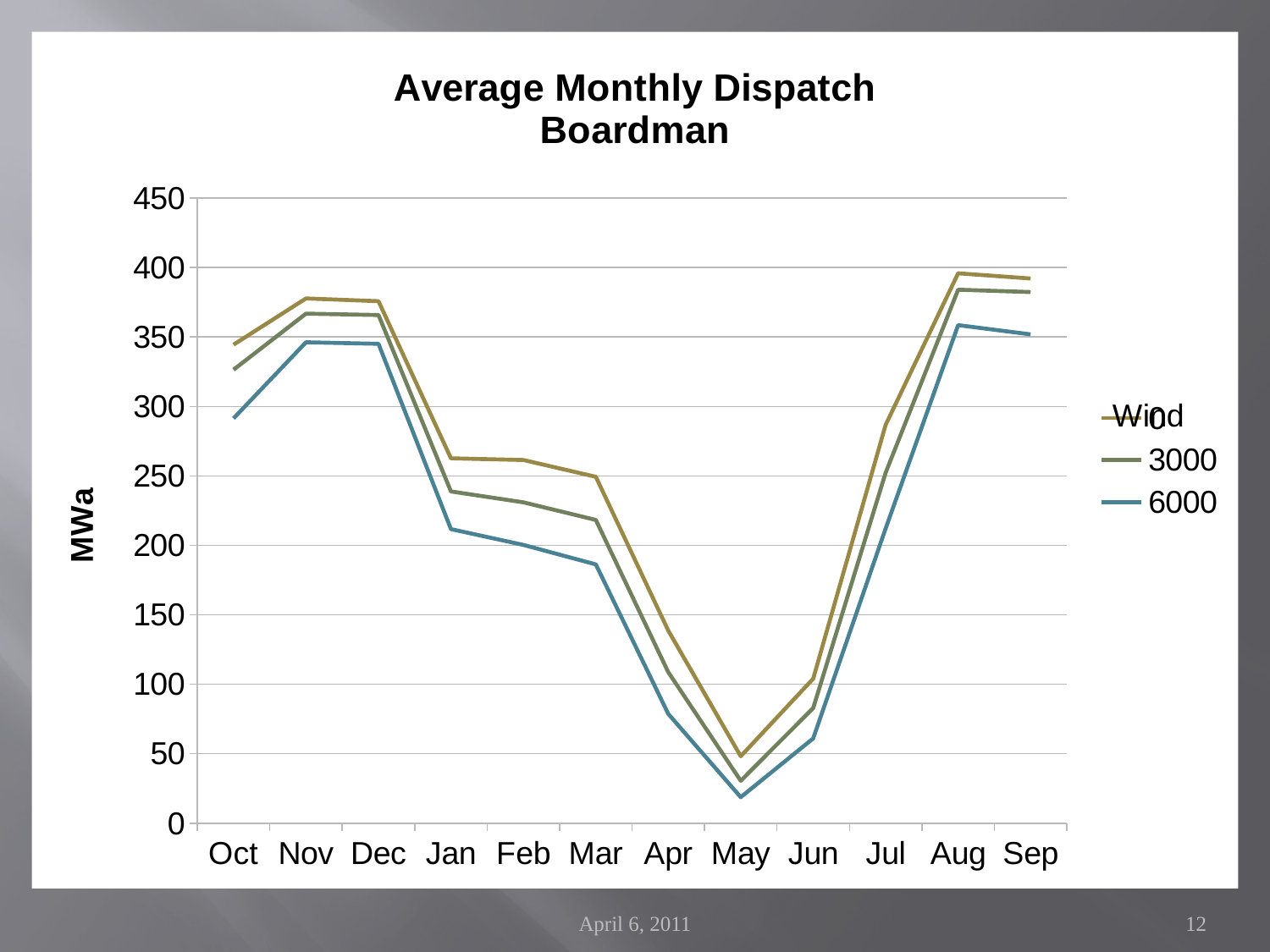
What kind of chart is shown on the slide? line chart In which month is the 6000 series at its lowest? May What is the title of the chart? Average Monthly Dispatch Boardman Do the values of the 6000 series rise or fall from Dec to May? fall How many months are plotted along the x axis? 12 Is the value of the 6000 series in May greater or less than 50? less Is the value of the 3000 series in Mar greater or less than 250? less What is the label on the vertical axis? MWa How many series does the legend list? 3 Is the value of the 3000 series in Aug greater or less than 350? greater For the 6000 series, which month has the larger value, Oct or Nov? Nov In which month is the 3000 series at its highest? Aug